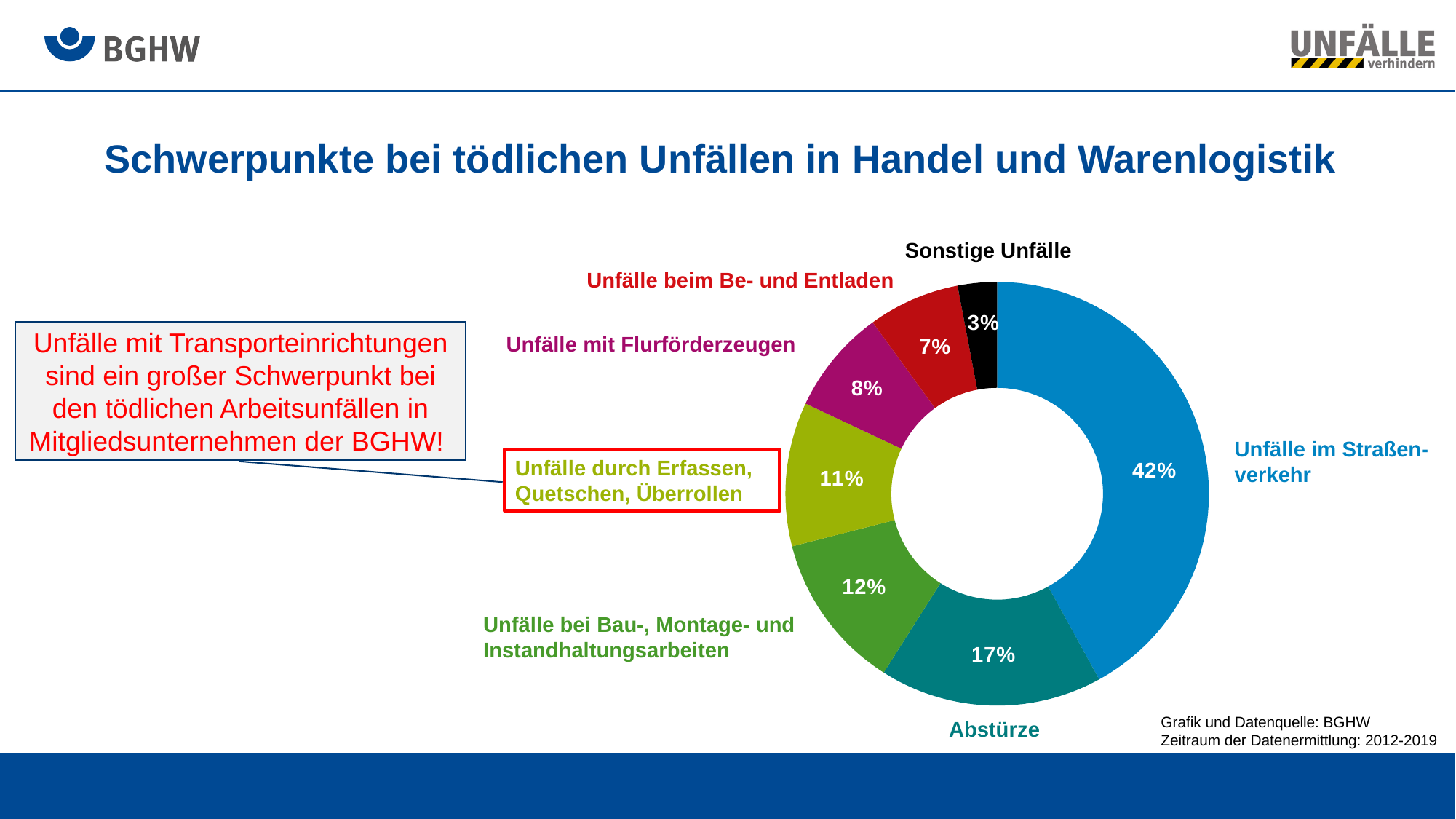
Which category has the smallest share of the chart? Sonstige Unfälle What percentage is shown for "Unfälle mit Flurförderzeugen"? 8% What kind of chart is shown on the slide? Pie chart (donut) What is the difference in percentage points between "Unfälle im Straßenverkehr" and "Abstürze"? 25 percentage points What percentage is shown for "Unfälle beim Be- und Entladen"? 7% What percentage is shown for "Abstürze"? 17% What percentage is shown for "Unfälle bei Bau-, Montage- und Instandhaltungsarbeiten"? 12% Which category has the largest share of the chart? Unfälle im Straßenverkehr What percentage is shown for "Unfälle durch Erfassen, Quetschen, Überrollen"? 11% What share of fatal accidents is attributed to "Unfälle im Straßenverkehr"? 42% Which is larger: the share for "Unfälle mit Flurförderzeugen" or for "Unfälle beim Be- und Entladen"? Unfälle mit Flurförderzeugen How many categories are shown in the chart? 7